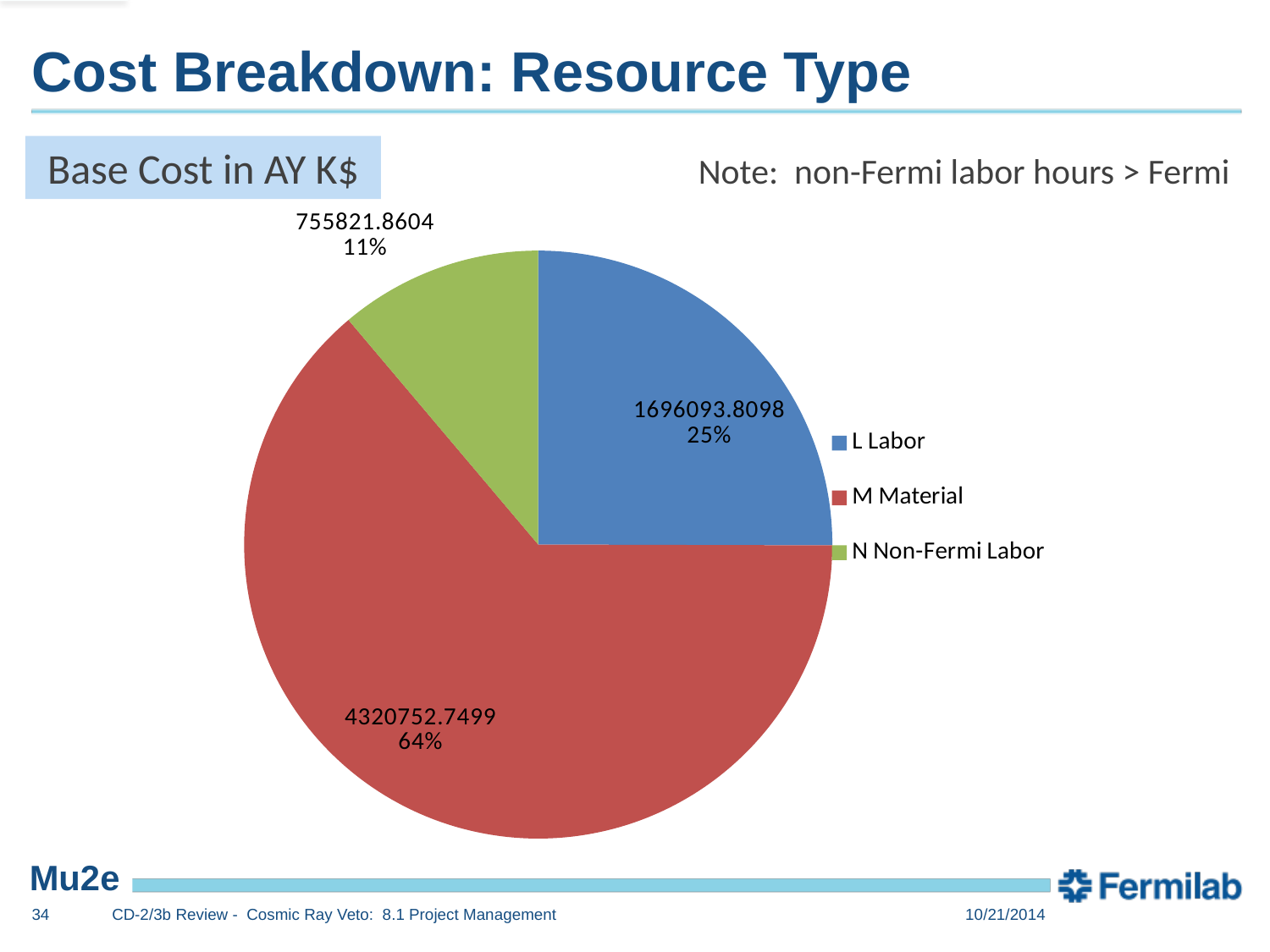
What is the value for N Non-Fermi Labor? 755821.8604 What is the value for L Labor? 1696093.8098 Which is larger, the value for L Labor or the value for N Non-Fermi Labor? L Labor Which resource type has the largest cost? M Material What is the value for M Material? 4320752.7499 What type of chart is shown on the slide? pie chart What is the difference between the M Material value and the L Labor value? 2624658.9401 How many categories does the legend list? 3 What share of the pie does M Material represent? 64% What share of the pie does N Non-Fermi Labor represent? 11% Which resource type has the smallest cost? N Non-Fermi Labor What share of the pie does L Labor represent? 25%